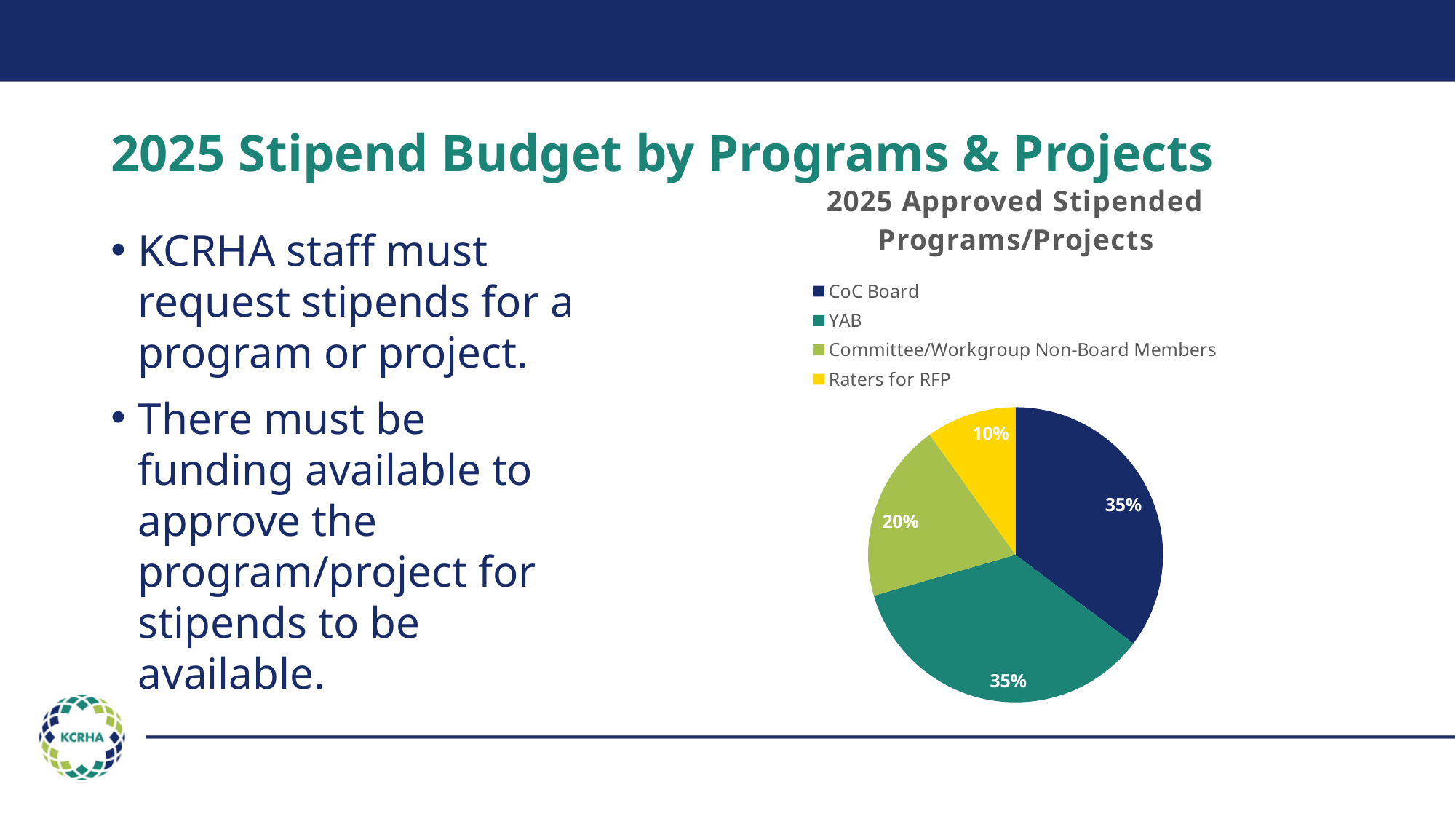
What is the title of the chart? 2025 Approved Stipended Programs/Projects What share of the pie does Raters for RFP have? 10% Which is larger, the share for YAB or the share for Raters for RFP? YAB What share of the pie does YAB have? 35% Which colour represents Raters for RFP in the pie chart? Yellow Which category has the smallest slice of the pie? Raters for RFP What kind of chart is shown on the slide? Pie chart What share of the pie does Committee/Workgroup Non-Board Members have? 20% How many categories does the pie chart show? 4 What is the difference between the shares for Committee/Workgroup Non-Board Members and Raters for RFP? 10% What is the difference between the shares for CoC Board and Committee/Workgroup Non-Board Members? 15%